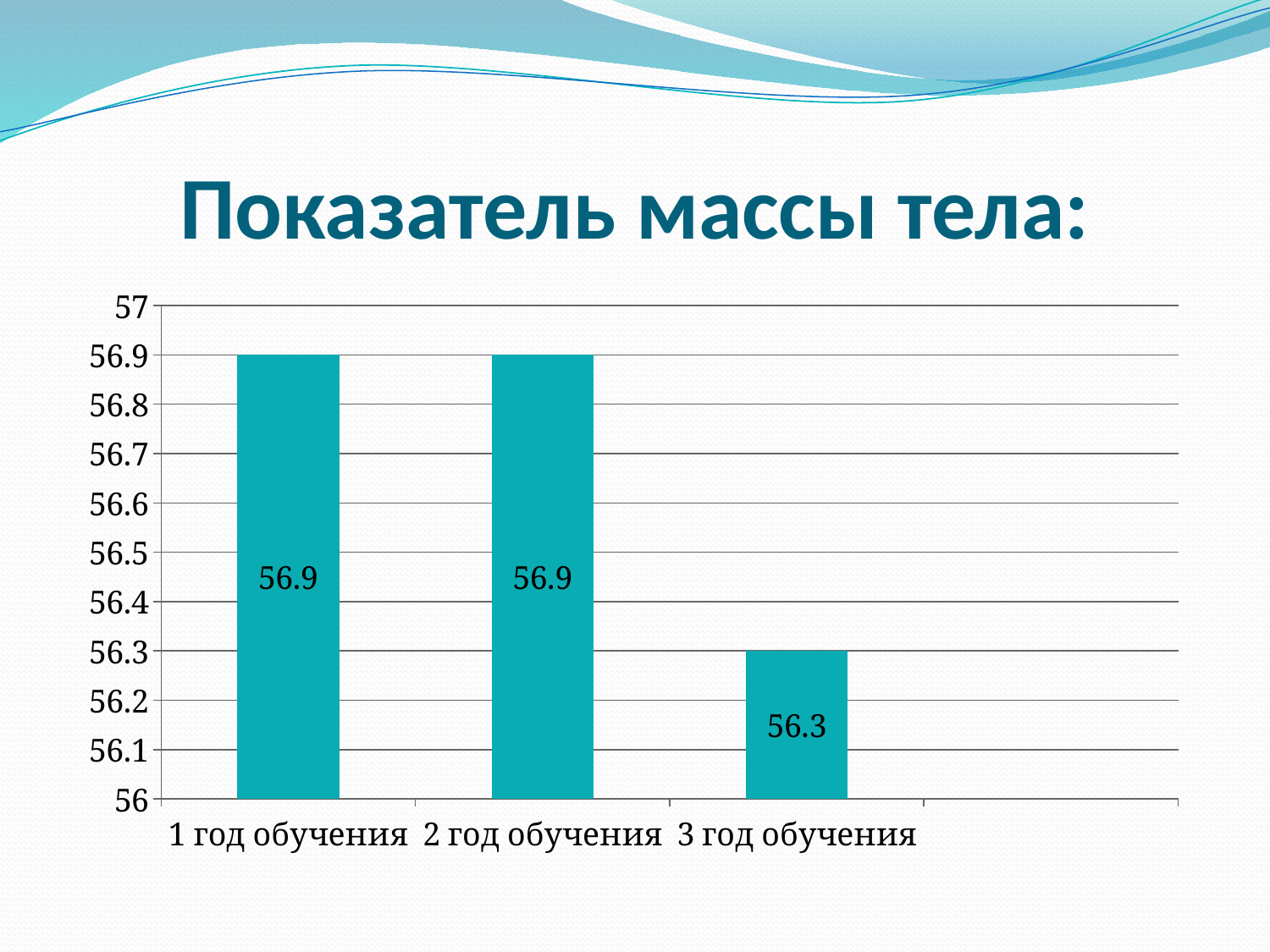
What kind of chart is shown on the slide? bar chart Which is larger, the value for 2 год обучения or 3 год обучения? 2 год обучения How many categories are shown on the x axis? 3 Do the values rise or fall from 2 год обучения to 3 год обучения? fall What is the value for 2 год обучения? 56.9 Is the value for 1 год обучения greater or less than 56.5? greater What is the title of the slide? Показатель массы тела: What is the value for 1 год обучения? 56.9 What is the difference between the values for 1 год обучения and 3 год обучения? 0.6 Is the value for 3 год обучения greater or less than 56.5? less What is the value for 3 год обучения? 56.3 Which category has the lowest value? 3 год обучения